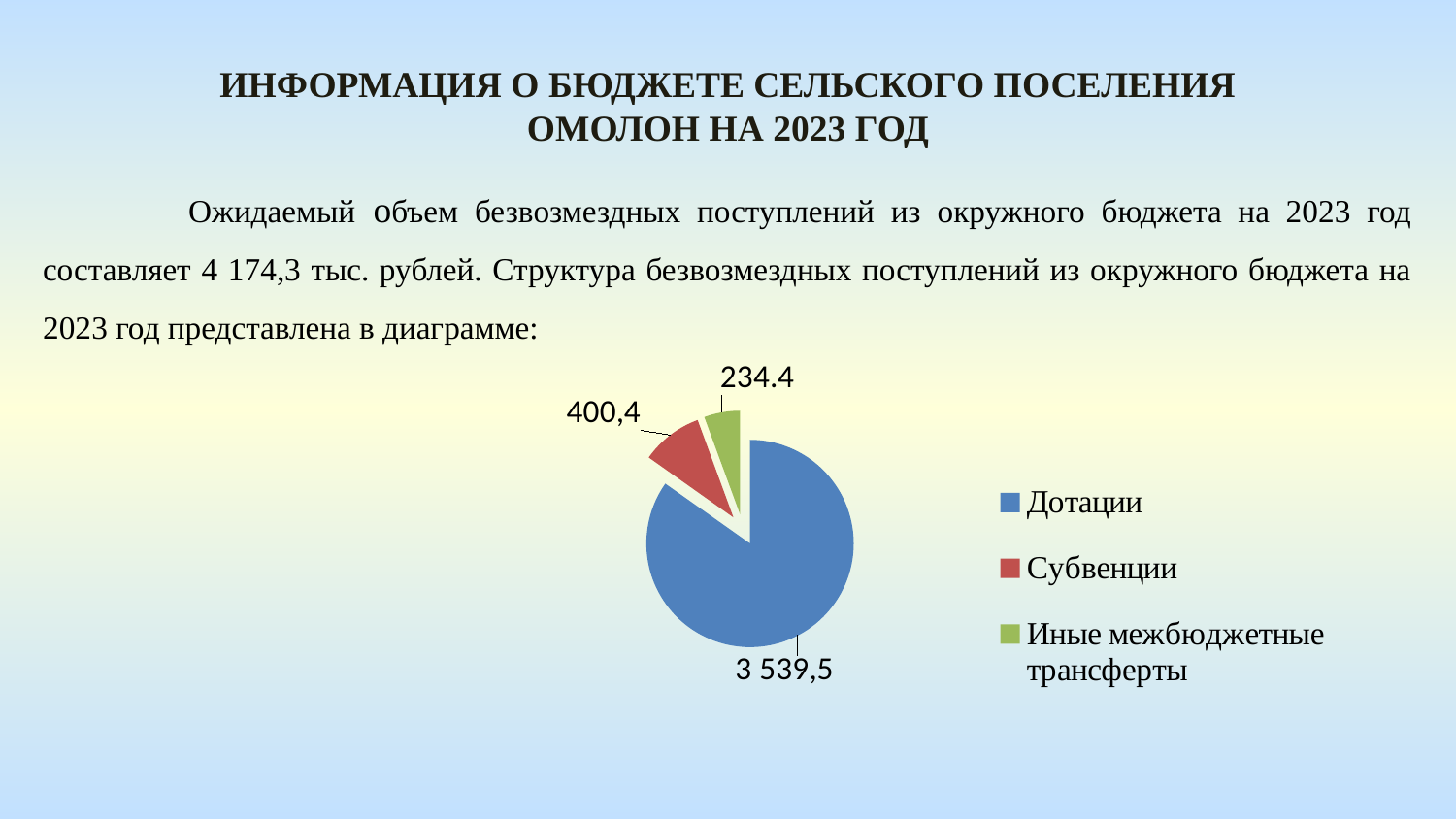
What is the difference between the Дотации and Субвенции values? 3 139,1 What is the value of the Иные межбюджетные трансферты slice? 234.4 What is the difference between the Субвенции and Иные межбюджетные трансферты values? 166 What colour is the Субвенции slice? red What is the value of the Субвенции slice? 400,4 Which category has the smallest slice of the pie? Иные межбюджетные трансферты Which is larger, Субвенции or Иные межбюджетные трансферты? Субвенции How many entries does the legend list? 3 What type of chart is shown on the slide? pie chart Which category has the largest slice of the pie? Дотации What is the value of the Дотации slice? 3 539,5 How many slices does the pie chart have? 3